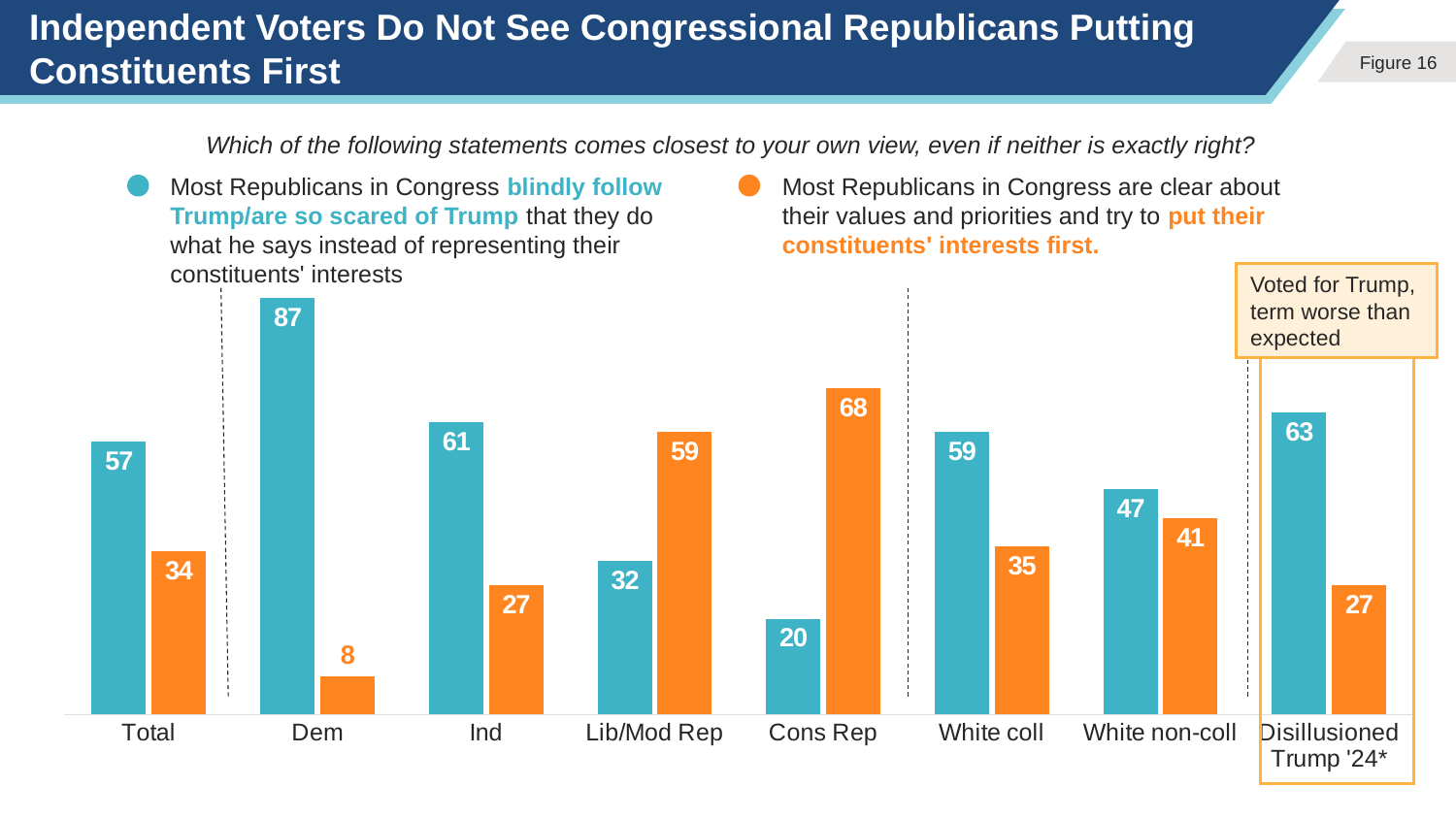
How many groups are shown along the x axis of the chart? 8 Which group has the lowest value for the 'put their constituents' interests first' statement? Dem What value is shown for Cons Rep for the statement that Republicans in Congress put their constituents' interests first? 68 What is the value for Dem for the 'put their constituents' interests first' statement? 8 What is the value for Disillusioned Trump '24* for the 'blindly follow Trump/are so scared of Trump' statement? 63 Which colour represents the statement that most Republicans in Congress put their constituents' interests first? orange Which group has the highest value for the 'blindly follow Trump/are so scared of Trump' statement? Dem What is the difference between the two values shown for White non-coll? 6 What percentage of Independents say most Republicans in Congress blindly follow Trump/are so scared of Trump? 61 What type of chart is shown on the slide? bar chart How many statements (series) does the chart compare? 2 For Lib/Mod Rep, which statement has the larger value: 'blindly follow Trump' or 'put their constituents' interests first'? put their constituents' interests first